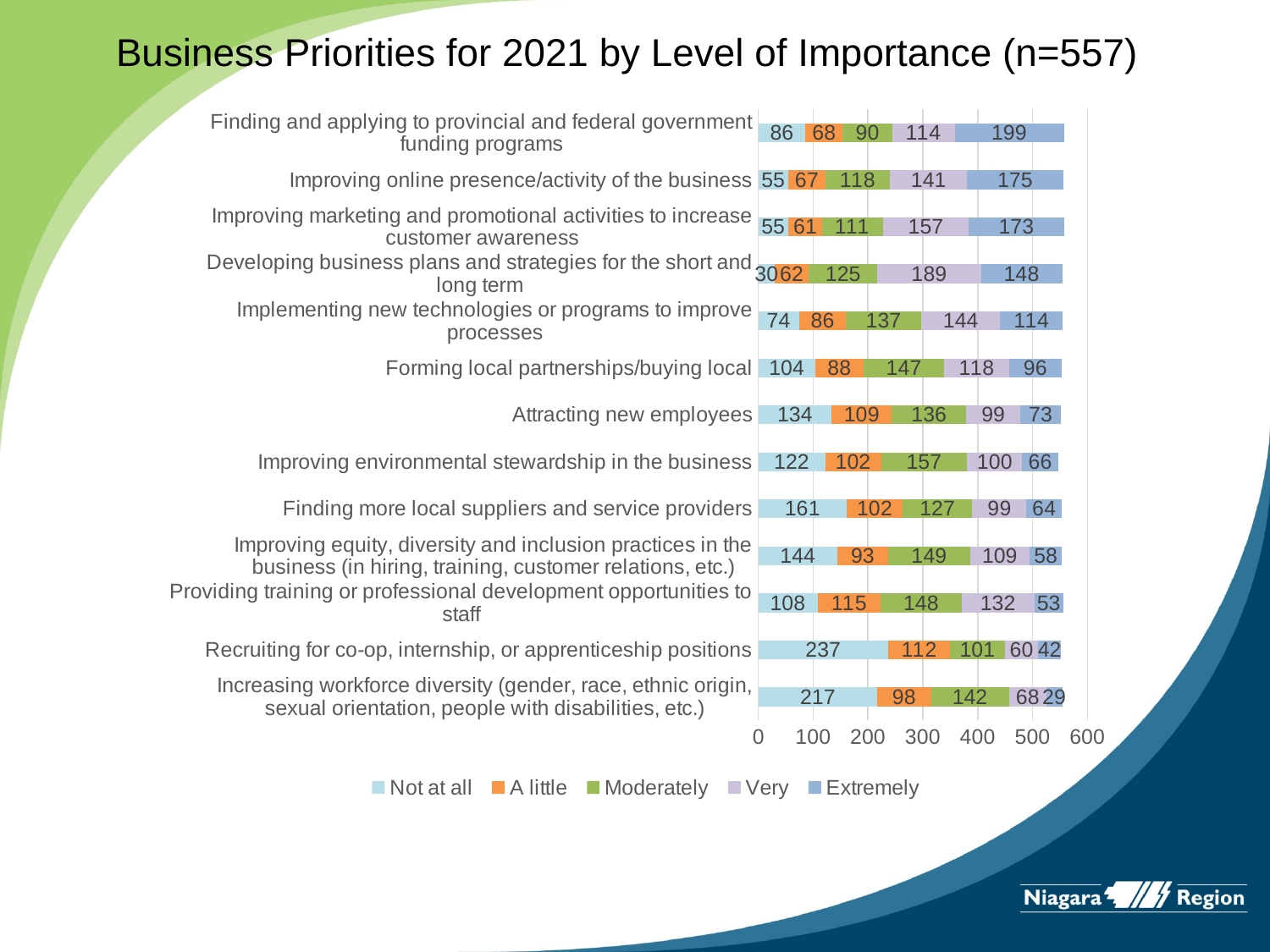
Which priority has the lowest 'Extremely' value? Increasing workforce diversity (gender, race, ethnic origin, sexual orientation, people with disabilities, etc.) What is the difference between the 'Not at all' values for 'Recruiting for co-op, internship, or apprenticeship positions' and 'Increasing workforce diversity'? 20 What is the total of the stacked bar for 'Improving online presence/activity of the business'? 556 What is the 'Very' value for 'Developing business plans and strategies for the short and long term'? 189 How many series does the legend list? 5 How many business priorities (categories) are plotted in the chart? 13 Which priority has the highest 'Extremely' value? Finding and applying to provincial and federal government funding programs What is the 'Extremely' value for 'Finding and applying to provincial and federal government funding programs'? 199 Which is larger: the 'Moderately' value for 'Improving environmental stewardship in the business' or for 'Attracting new employees'? Improving environmental stewardship in the business What type of chart is shown on the slide? Stacked bar chart Which legend entry is shown in orange? A little What is the 'Not at all' value for 'Recruiting for co-op, internship, or apprenticeship positions'? 237